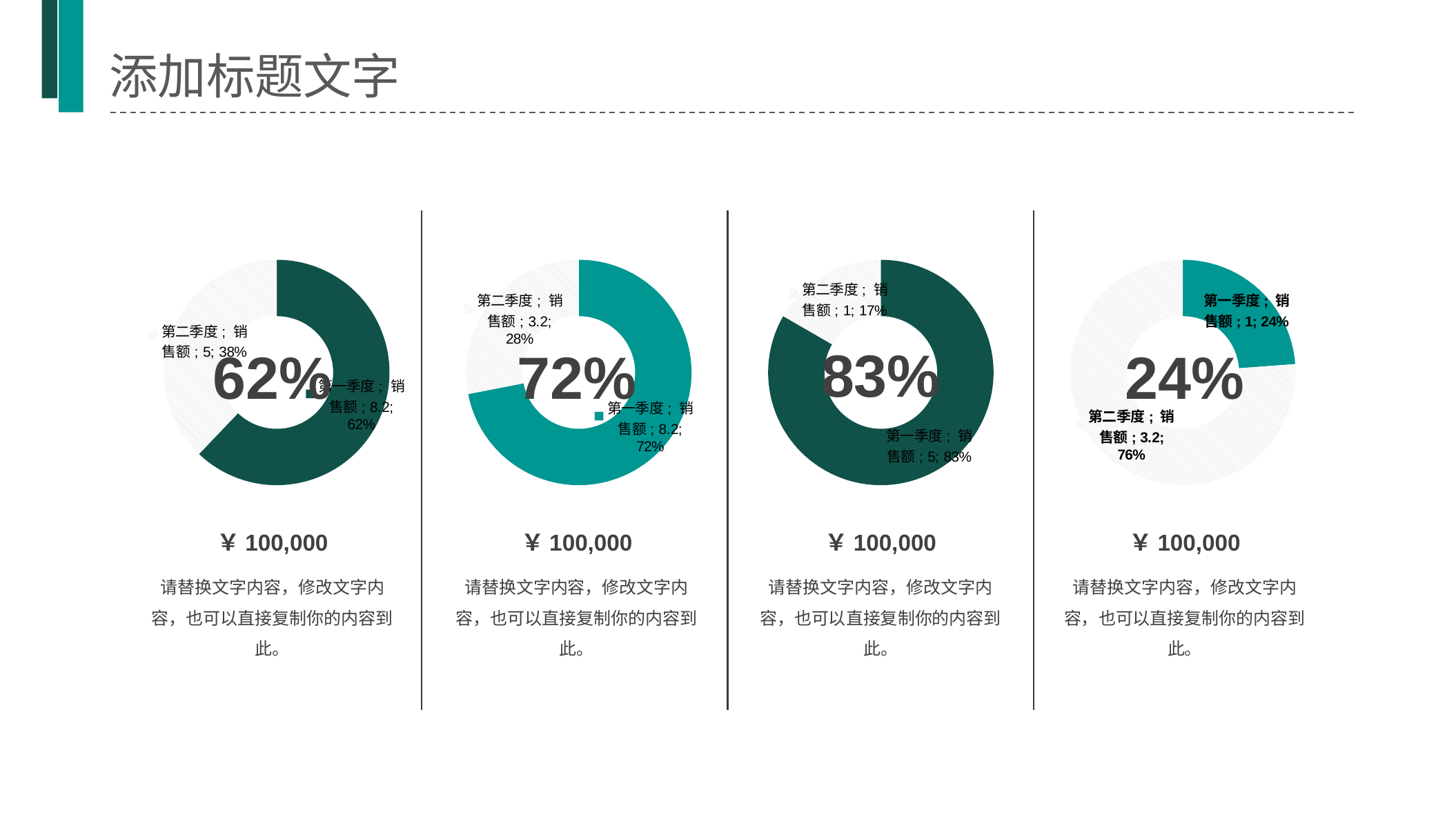
In the rightmost chart (24%), what is the 销售额 value for 第二季度? 3.2 In the leftmost chart (62%), what is the 销售额 value for 第一季度? 8.2 How many doughnut charts are shown on the slide? 4 How many slices does the rightmost chart (24%) have? 2 In the second chart from the left (72%), what is the difference between the 第一季度 and 第二季度 values? 5 In the second chart from the left (72%), which category has the larger slice, 第一季度 or 第二季度? 第一季度 In the rightmost chart (24%), which category has the smallest slice? 第一季度 What kind of chart is shown in the leftmost panel (62%)? doughnut chart In the leftmost chart (62%), what share of the doughnut does 第二季度 take? 38% In the second chart from the left (72%), what is the 销售额 value for 第二季度? 3.2 In the third chart from the left (83%), what share of the doughnut does 第二季度 take? 17% In the third chart from the left (83%), what is the 销售额 value for 第一季度? 5